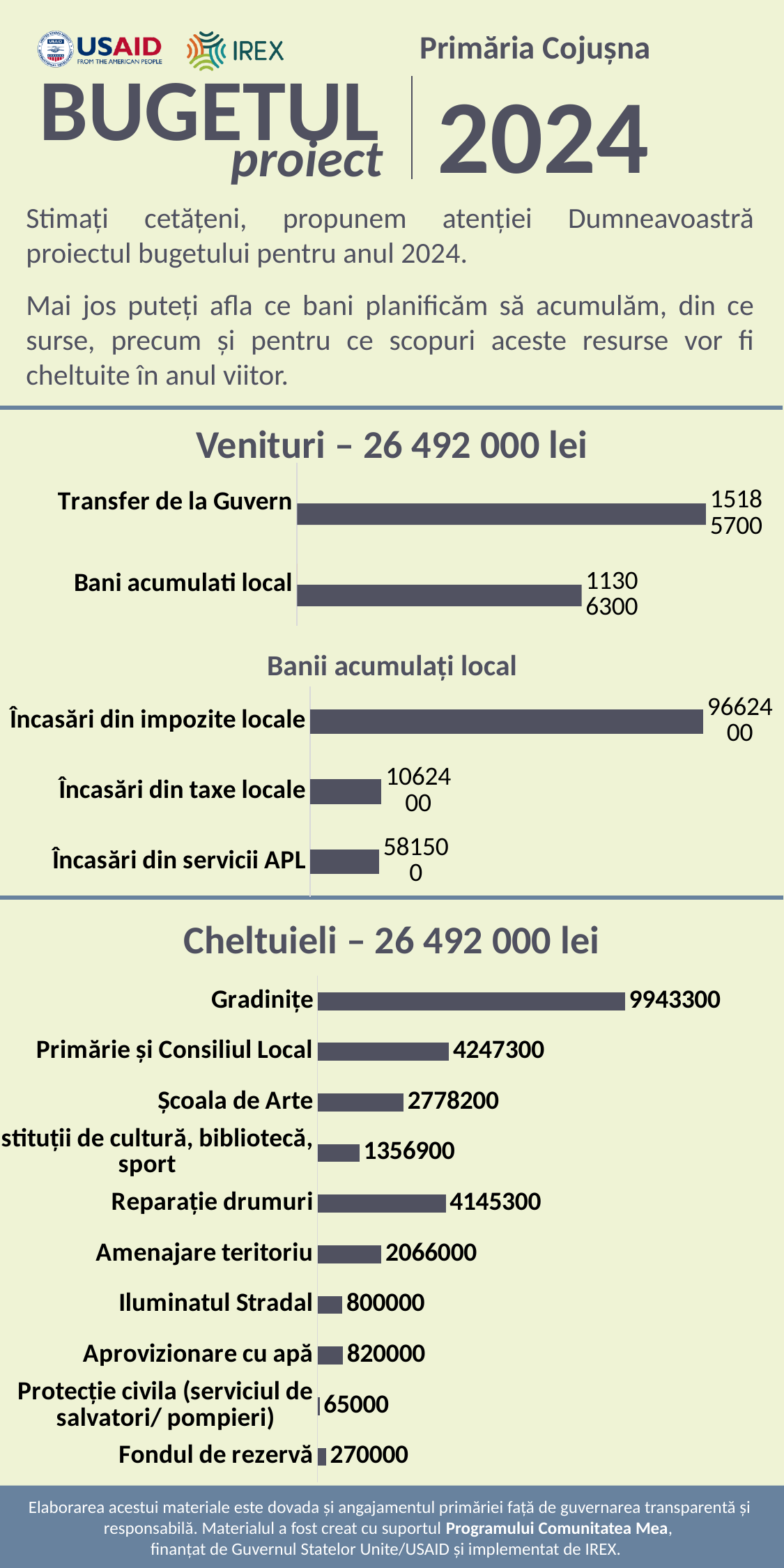
How many categories are shown in the 'Cheltuieli – 26 492 000 lei' chart? 10 In the 'Venituri – 26 492 000 lei' chart, what is the value for Bani acumulati local? 11306300 In the 'Venituri – 26 492 000 lei' chart, what is the value for Transfer de la Guvern? 15185700 In the 'Cheltuieli – 26 492 000 lei' chart, what is the difference between Gradinițe and Primărie și Consiliul Local? 5696000 In the 'Cheltuieli – 26 492 000 lei' chart, which category has the lowest value? Protecție civila (serviciul de salvatori/ pompieri) In the 'Cheltuieli – 26 492 000 lei' chart, what is the value for Reparație drumuri? 4145300 In the 'Banii acumulați local' chart, which category has the lowest value? Încasări din servicii APL What type of chart is the 'Cheltuieli – 26 492 000 lei' chart? Bar chart In the 'Cheltuieli – 26 492 000 lei' chart, which category has the highest value? Gradinițe How many categories are shown in the 'Banii acumulați local' chart? 3 In the 'Venituri – 26 492 000 lei' chart, which category has the larger value? Transfer de la Guvern In the 'Banii acumulați local' chart, what is the value for Încasări din taxe locale? 1062400